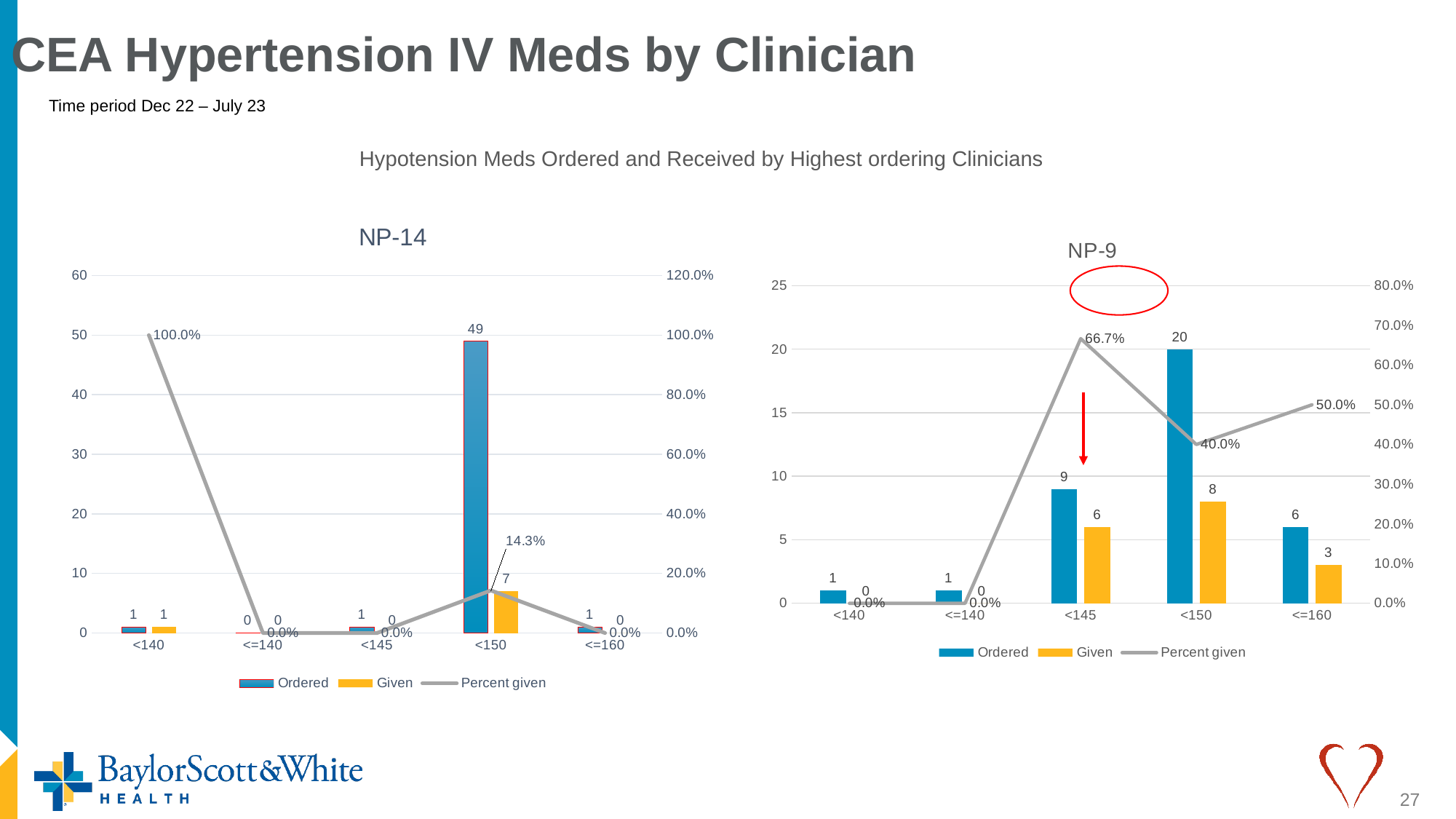
In the NP-9 chart, which category has the highest Ordered value? <150 In the NP-14 chart, what is the Percent given for the <150 category? 14.3% In the NP-9 chart, how many meds were Given for the <150 category? 8 In the NP-14 chart, what is the Percent given for the <140 category? 100.0% How many series does the legend of the NP-14 chart list? 3 In the NP-14 chart, how many meds were Ordered for the <150 category? 49 How many categories are shown on the x axis of the NP-9 chart? 5 In the NP-9 chart, which is larger, the Ordered value for <145 or the Ordered value for <=160? <145 In the NP-14 chart, what is the difference between Ordered and Given for the <150 category? 42 In the NP-9 chart, what is the difference between Ordered and Given for the <145 category? 3 In the NP-14 chart, which category has the highest Ordered value? <150 In the NP-9 chart, what is the Percent given for the <145 category? 66.7%